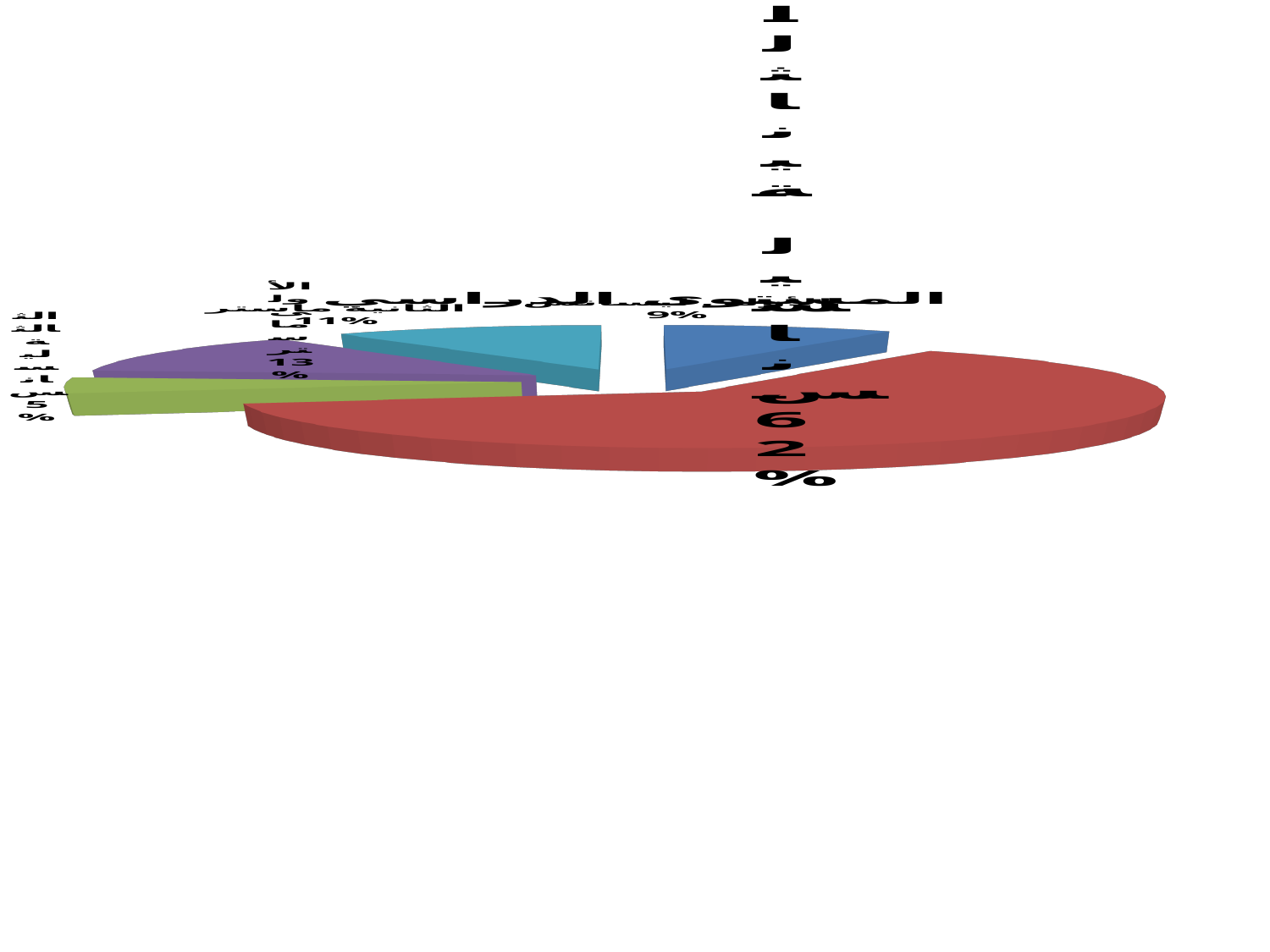
What percentage is labelled on the teal slice of the pie chart? 11% Which slice is larger, the red slice or the purple slice? the red slice What percentage is labelled on the green slice of the pie chart? 5% What is the difference in percentage points between the red slice (62%) and the purple slice (13%)? 49 What percentage is labelled on the dark blue slice of the pie chart? 9% How many slices does the pie chart have? 5 What is the largest percentage shown on the pie chart? 62% What kind of chart is shown on the slide? pie chart What percentage is labelled on the red slice of the pie chart? 62% What is the smallest percentage shown on the pie chart? 5% What colour is the largest slice of the pie chart? red What percentage is labelled on the purple slice of the pie chart? 13%